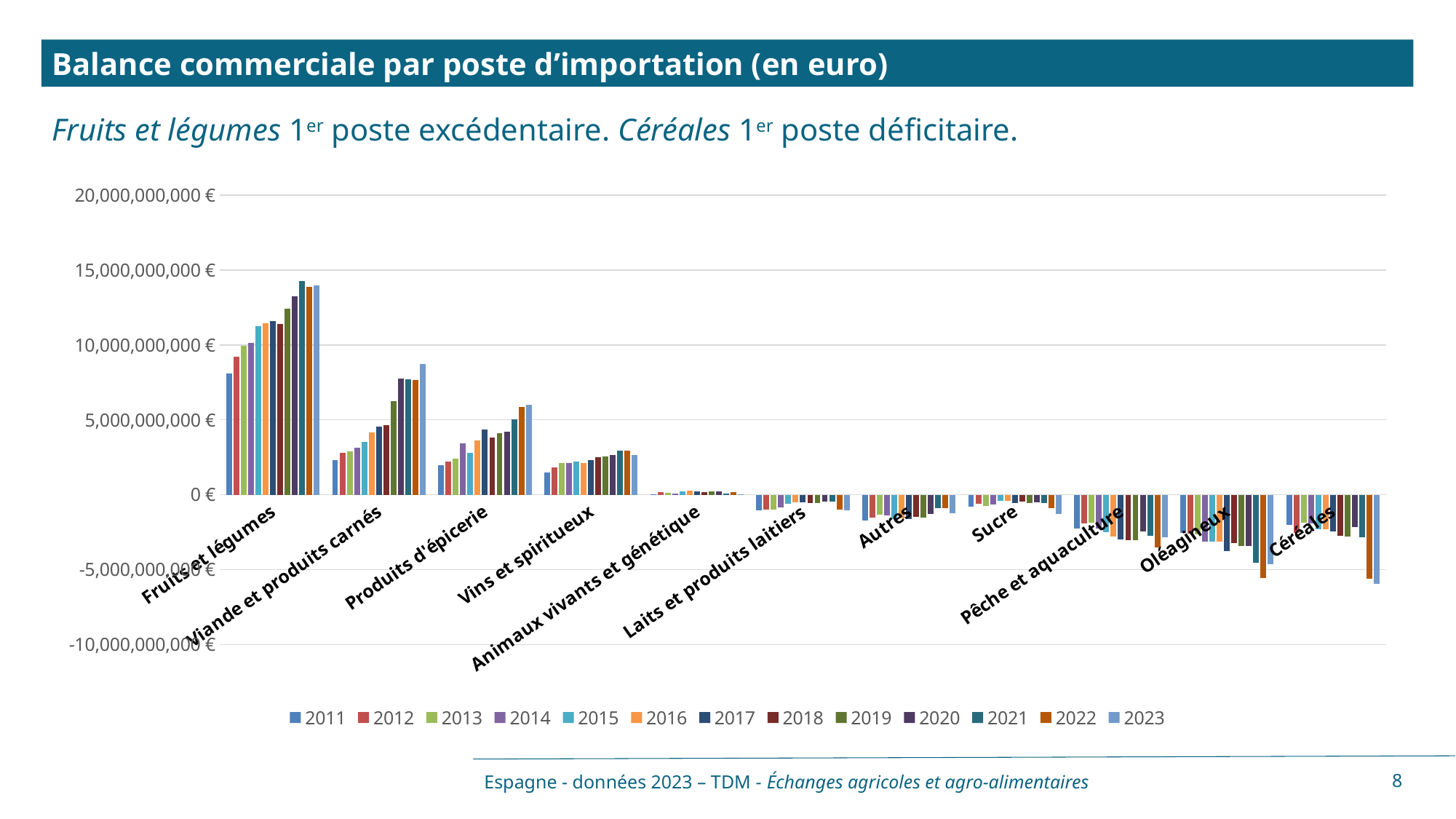
For Fruits et légumes, which is larger: the 2011 value or the 2021 value? 2021 What is the title of the chart on the slide? Balance commerciale par poste d'importation (en euro) What kind of chart is shown on the slide? bar chart Which category has the lowest (most negative) values in the chart? Céréales Is the value for Céréales in 2023 greater or less than -5,000,000,000 €? less How many categories are shown on the x axis of the chart? 11 Is the value for Viande et produits carnés in 2023 greater or less than 5,000,000,000 €? greater Do the values for Viande et produits carnés generally rise or fall from 2011 to 2023? rise Which is larger in 2023: Fruits et légumes or Viande et produits carnés? Fruits et légumes Is the value for Fruits et légumes in 2023 greater or less than 10,000,000,000 €? greater How many series does the chart legend list? 13 Which category has the highest values in the chart? Fruits et légumes